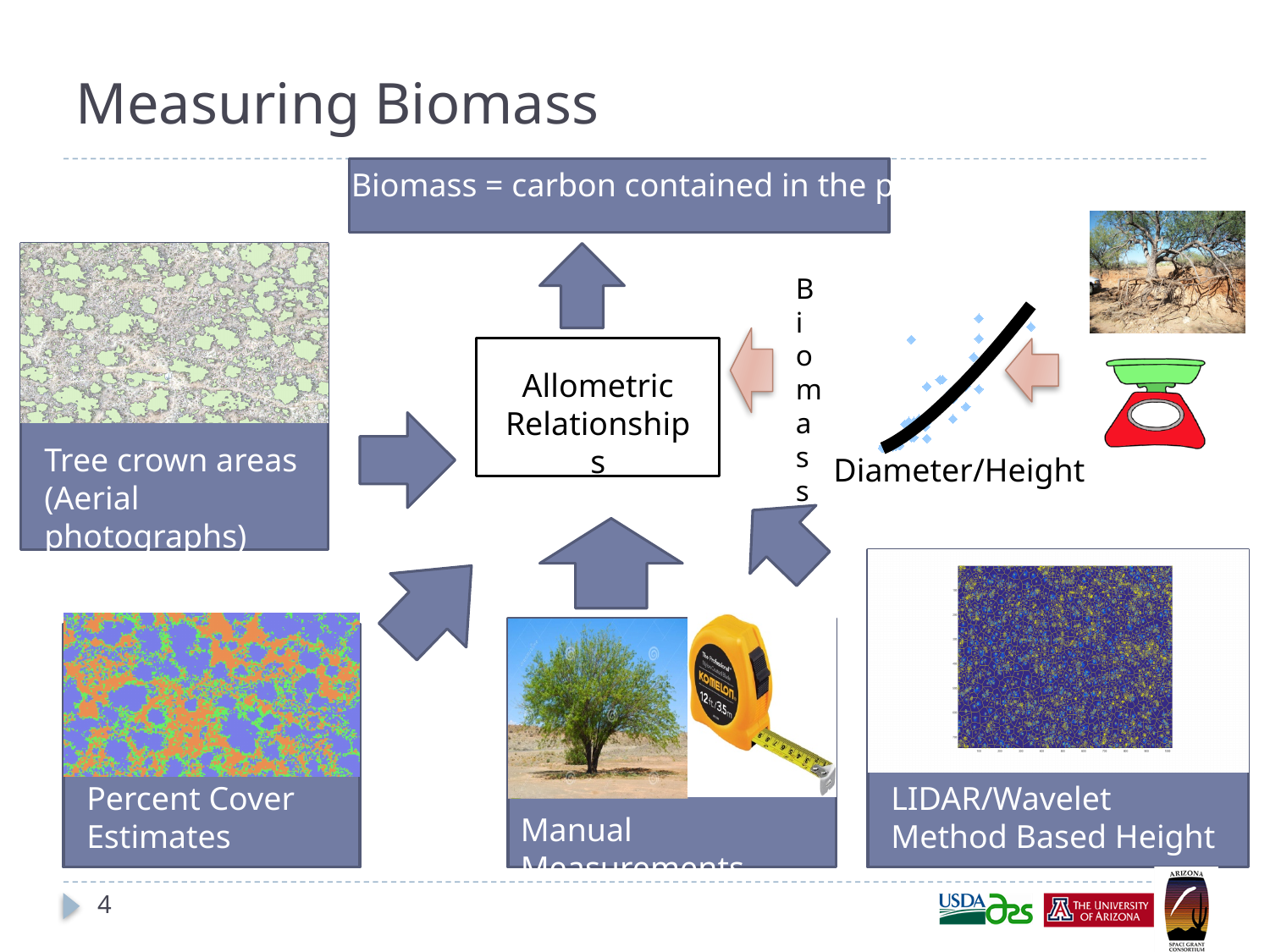
What kind of chart is the small plot labelled Biomass versus Diameter/Height? scatter plot What is the label on the horizontal axis of the scatter plot next to the Allometric Relationships box? Diameter/Height What is the label on the vertical axis of the scatter plot next to the Allometric Relationships box? Biomass In the Biomass versus Diameter/Height plot, does biomass rise or fall as diameter/height increases? rise